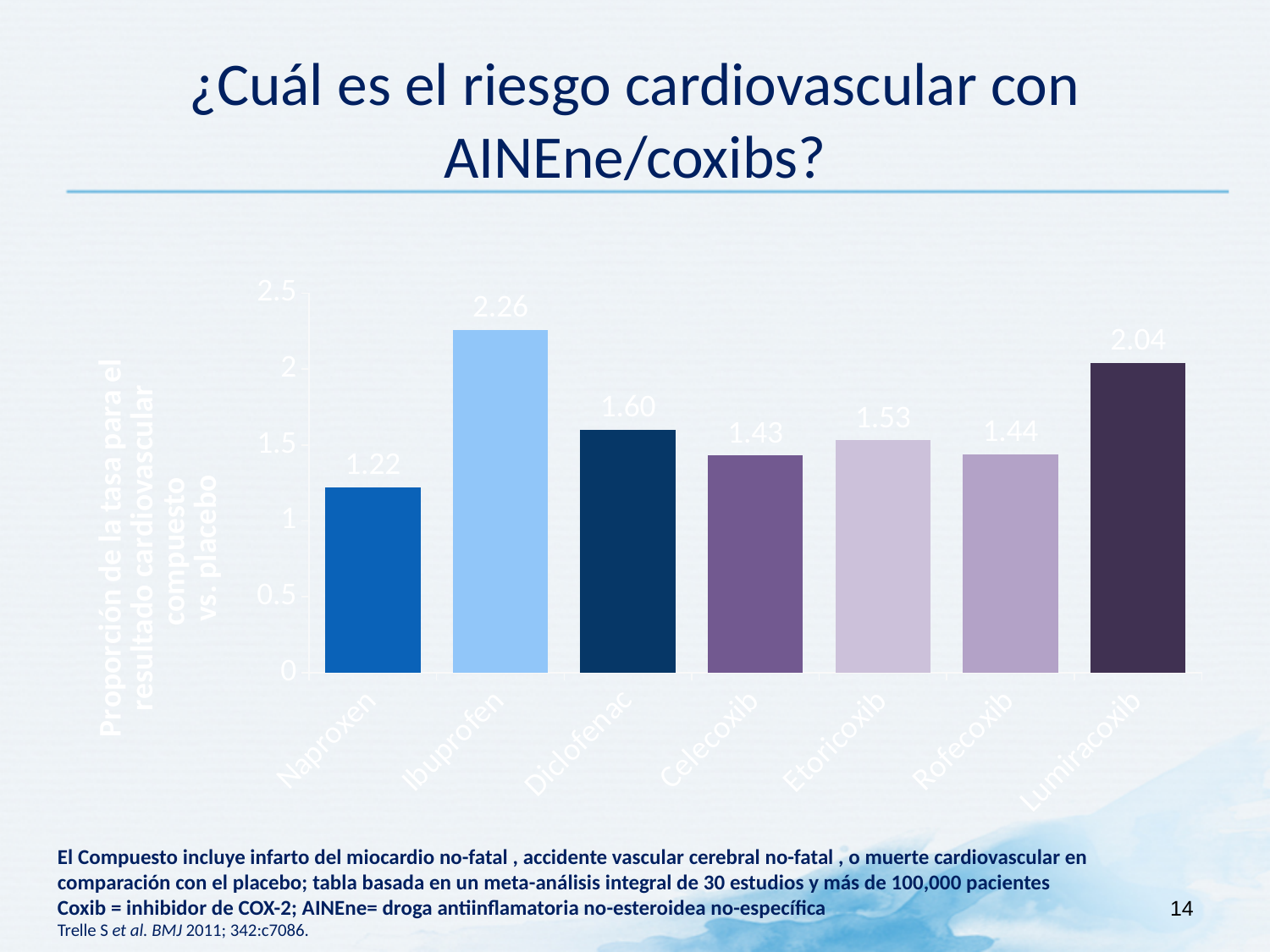
What kind of chart is shown on the slide? Bar chart What is the value for Lumiracoxib? 2.04 What is the difference between the values for Ibuprofen and Naproxen? 1.04 Which drug has the lowest value? Naproxen What is the value for Naproxen? 1.22 How many drugs are shown on the x axis? 7 Is the value for Lumiracoxib greater or less than 2? greater What is the value for Etoricoxib? 1.53 Which is larger, the value for Diclofenac or the value for Celecoxib? Diclofenac What is the value for Ibuprofen? 2.26 Which drug has the highest value? Ibuprofen What is the difference between the values for Lumiracoxib and Diclofenac? 0.44